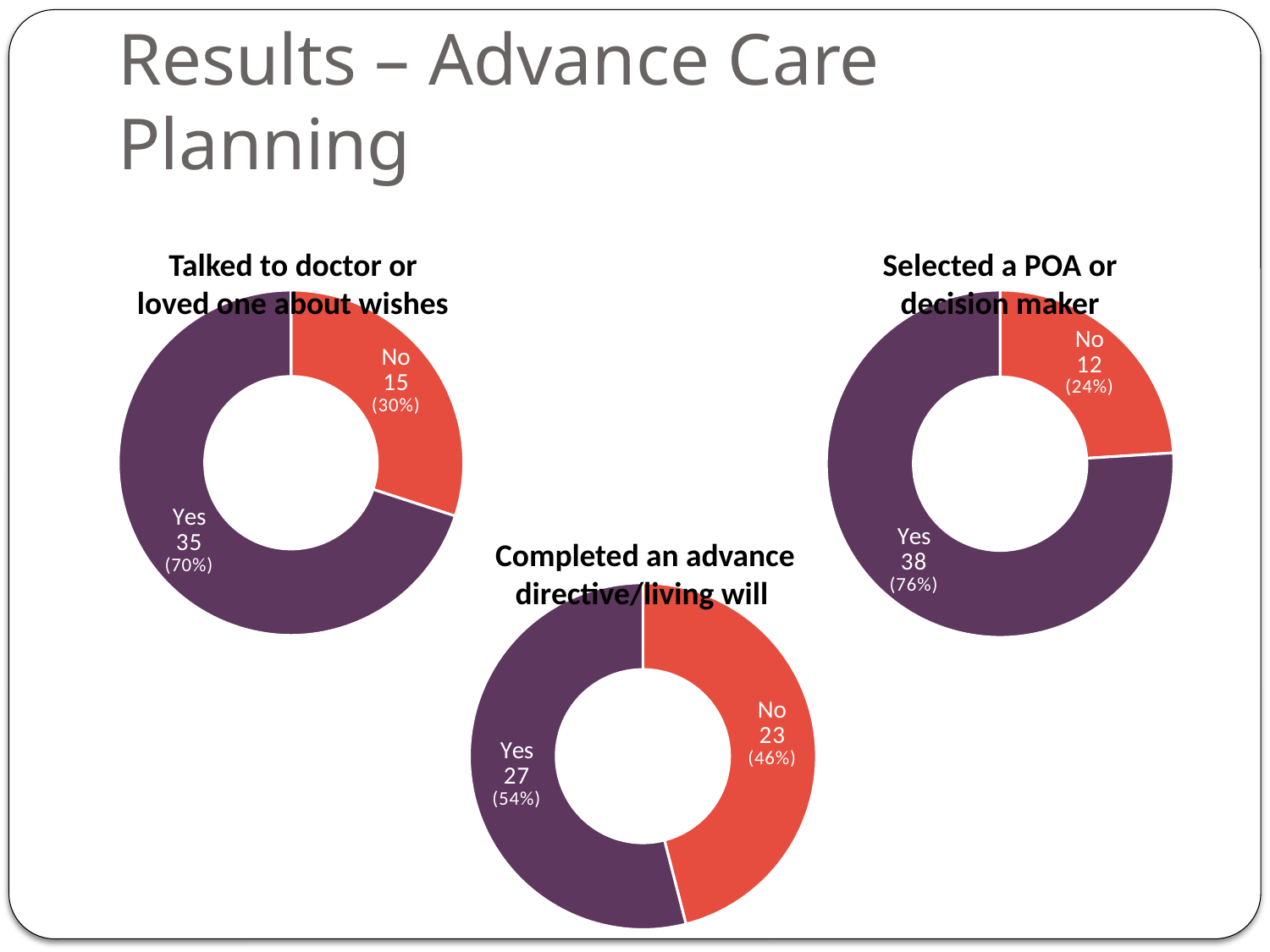
In the 'Completed an advance directive/living will' chart, how many respondents answered Yes? 27 In the 'Selected a POA or decision maker' chart, how many respondents answered No? 12 In the 'Talked to doctor or loved one about wishes' chart, how many respondents answered Yes? 35 In the 'Talked to doctor or loved one about wishes' chart, what colour is the Yes slice? Purple In the 'Completed an advance directive/living will' chart, what is the difference between the Yes and No counts? 4 What kind of chart is used for 'Selected a POA or decision maker'? Doughnut (pie) chart In the 'Selected a POA or decision maker' chart, what share of respondents answered Yes? 76% How many slices does the 'Completed an advance directive/living will' chart have? 2 In the 'Completed an advance directive/living will' chart, what percentage answered No? 46% In the 'Selected a POA or decision maker' chart, which slice is larger, Yes or No? Yes In the 'Talked to doctor or loved one about wishes' chart, what percentage answered No? 30% In the 'Talked to doctor or loved one about wishes' chart, what is the total number of respondents? 50